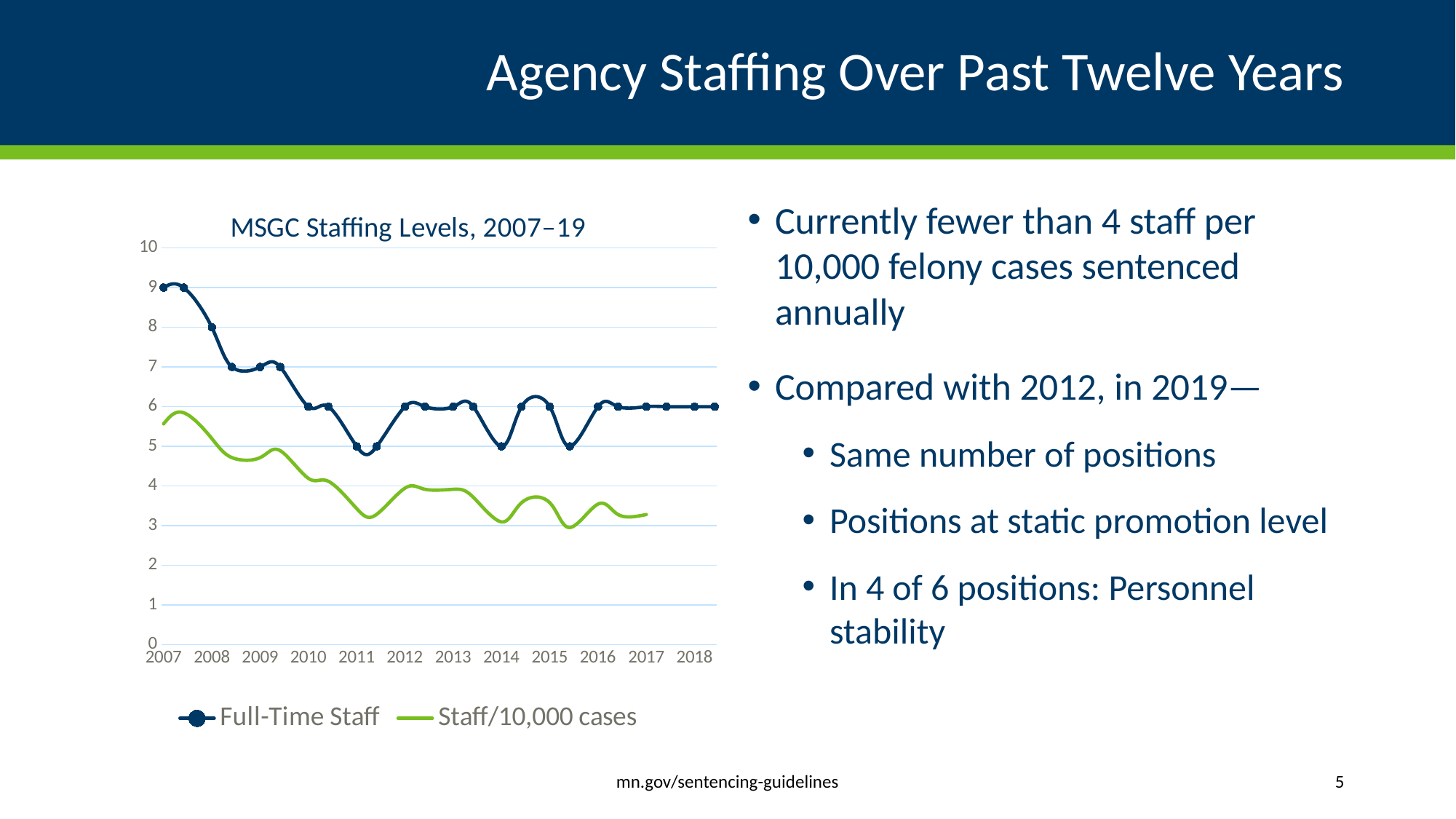
In 2012, which series has the larger value, Full-Time Staff or Staff/10,000 cases? Full-Time Staff What is the title of the chart? MSGC Staffing Levels, 2007–19 What kind of chart is shown on the slide? line chart What is the lowest value reached by the Full-Time Staff series? 5 What is the difference between the Full-Time Staff value at the start of 2007 and the value in 2018? 3 Is the value for Staff/10,000 cases in 2017 greater or less than 4? less In which year is the Full-Time Staff series at its highest? 2007 What is the Full-Time Staff value in 2018? 6 Does the Full-Time Staff series rise or fall from 2007 to 2011? fall What is the Full-Time Staff value at the start of 2007? 9 How many series does the chart legend list? 2 Is the value for Staff/10,000 cases in 2007 greater or less than 5? greater